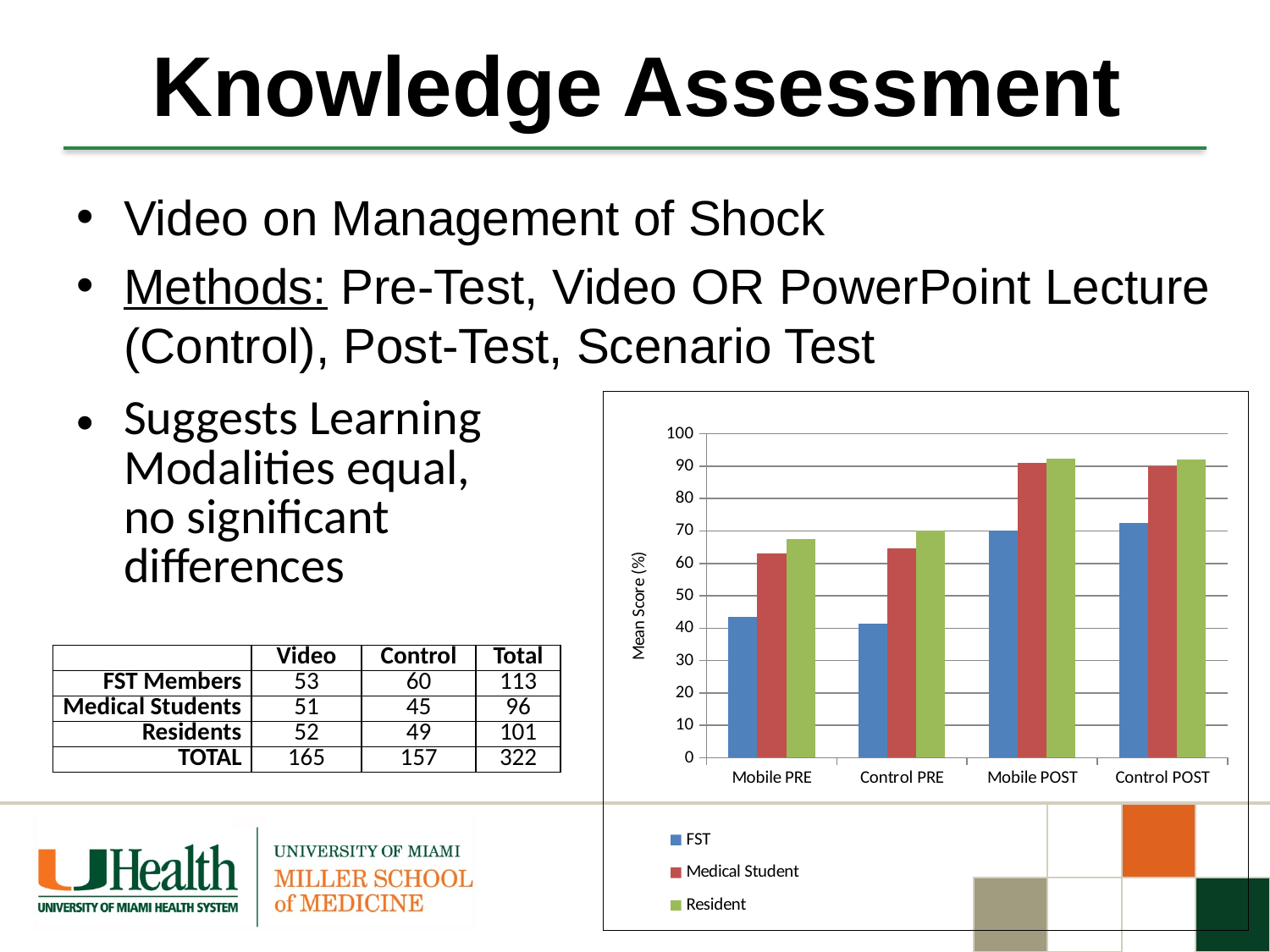
In the Mobile PRE category, which is larger: the FST value or the Resident value? Resident Is the FST value for Mobile PRE greater or less than 50? less Which series has the highest value in the Mobile PRE category? Resident How many series does the chart legend list? 3 What is the label on the y axis of the chart? Mean Score (%) What kind of chart is shown on the slide? bar chart Is the Resident value for Control PRE greater or less than 60? greater Which is larger for FST: the Mobile PRE value or the Mobile POST value? Mobile POST Is the Medical Student value for Mobile POST greater or less than 80? greater Which series has the lowest value in the Mobile POST category? FST How many categories are shown on the x axis of the chart? 4